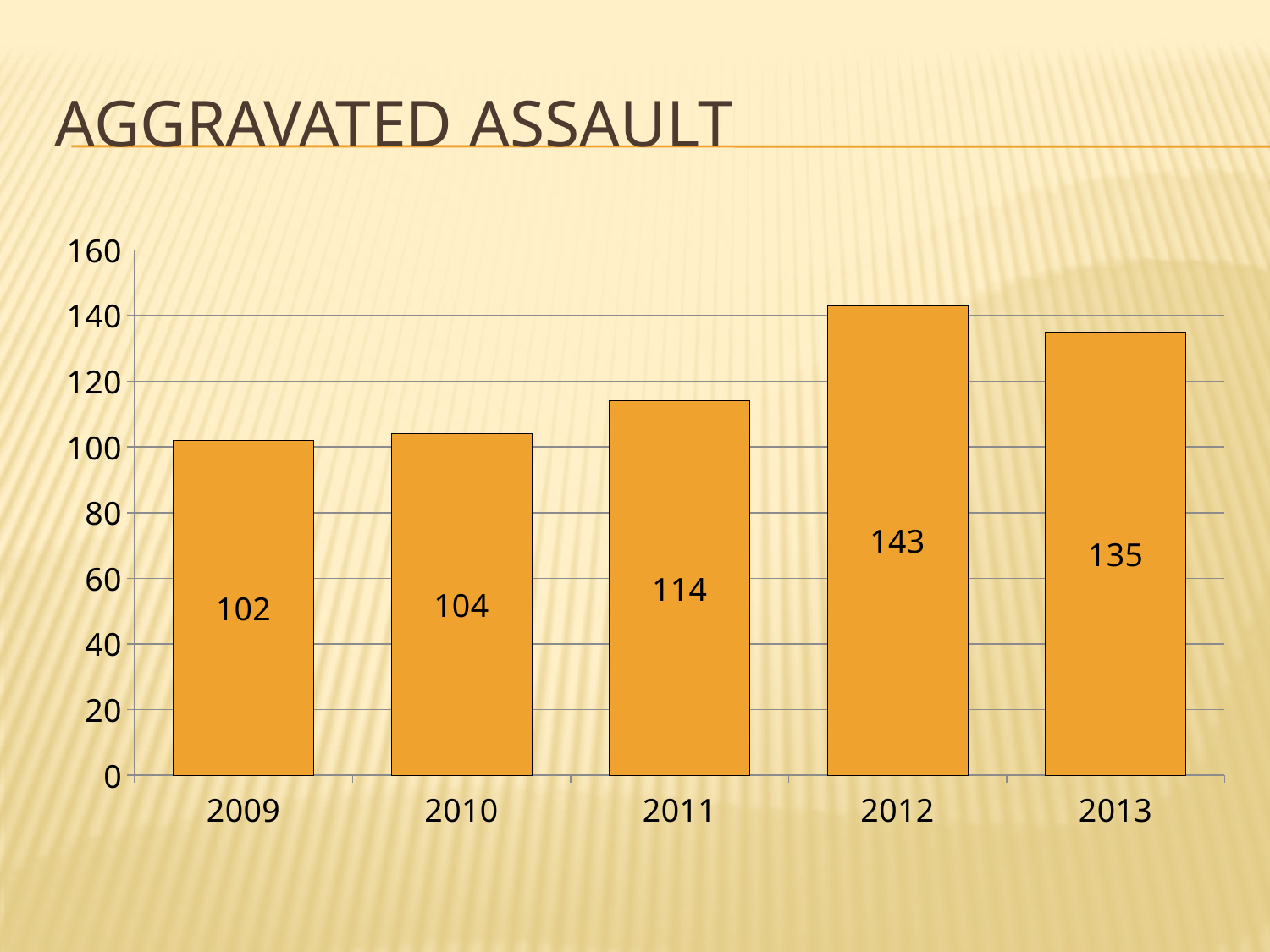
Which year has the lowest value? 2009 What is the value for 2009? 102 What is the difference between the values for 2012 and 2013? 8 Which year has the highest value? 2012 How many years are shown on the x axis? 5 What is the value for 2012? 143 What is the difference between the values for 2011 and 2009? 12 Is the value for 2012 greater or less than 140? greater Which is larger, the value for 2011 or the value for 2010? 2011 What kind of chart is shown on the slide? bar chart What is the title of the slide? AGGRAVATED ASSAULT What is the value for 2013? 135